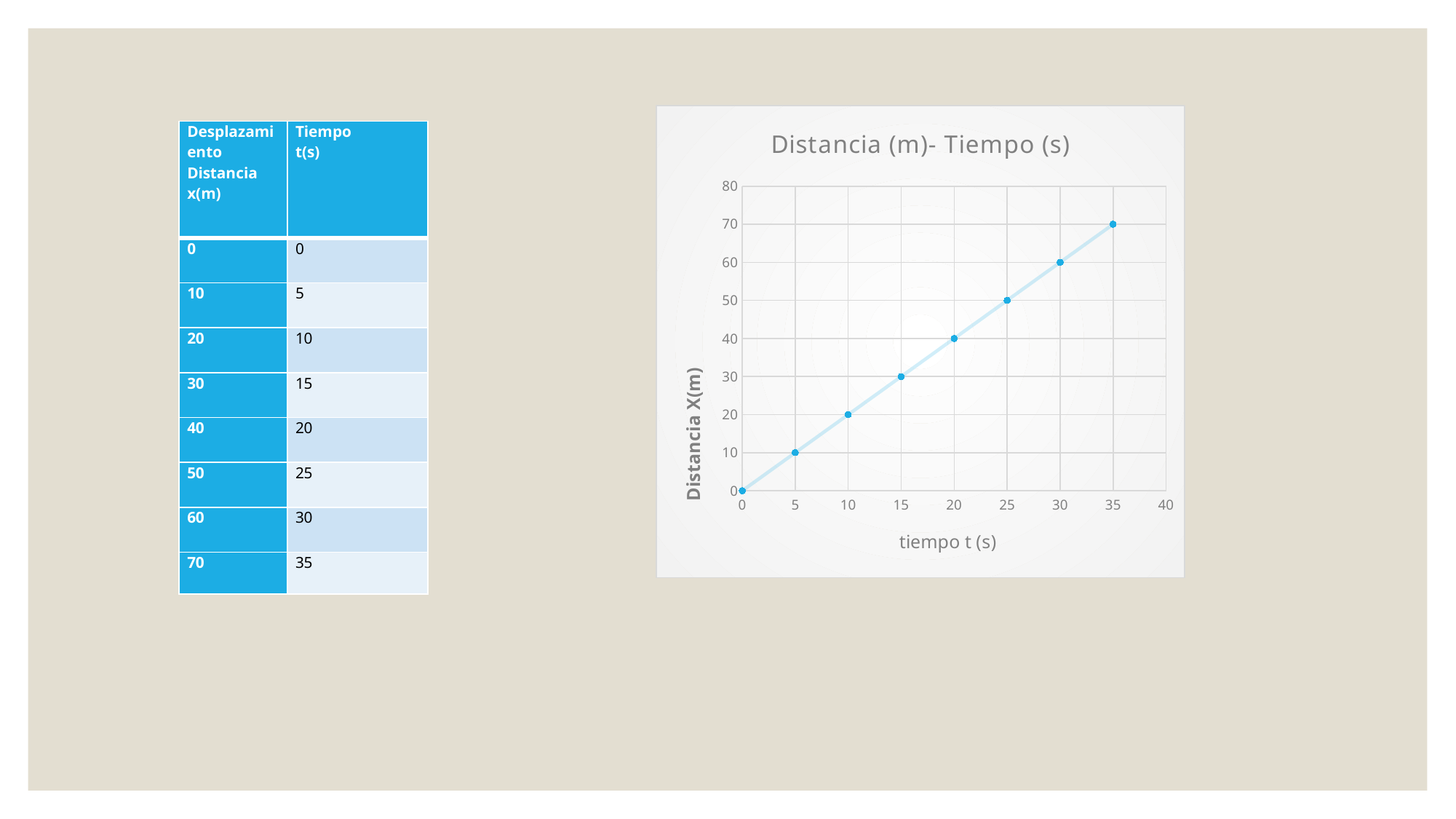
At which time value does the chart reach its highest distance? 35 At which time value is the distance lowest? 0 What kind of chart is shown on the slide? Scatter chart with a line What is the title of the chart? Distancia (m)- Tiempo (s) What is the distance (Distancia X(m)) at tiempo t = 15 s? 30 Which has a larger distance value: t = 20 s or t = 25 s? t = 25 s What is the difference in distance between t = 30 s and t = 10 s? 40 What is the label of the x axis? tiempo t (s) How many data points are plotted on the chart? 8 What is the distance (Distancia X(m)) at tiempo t = 5 s? 10 Do the distance values rise or fall as time increases along the x axis? Rise What is the distance (Distancia X(m)) at tiempo t = 35 s? 70